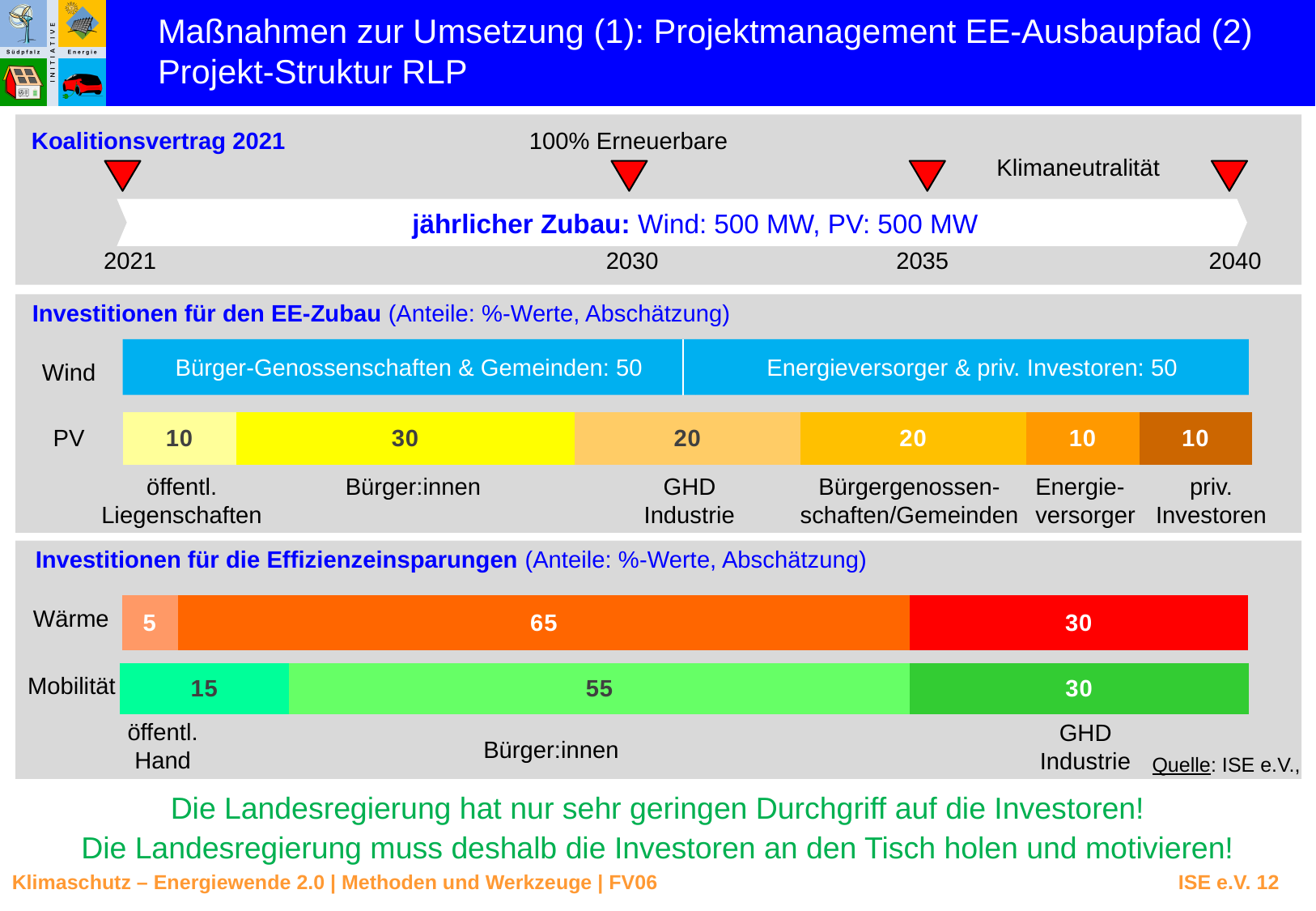
In the 'Investitionen für die Effizienzeinsparungen' chart, which is larger: the öffentl. Hand share for Wärme or for Mobilität? Mobilität What kind of chart is used in the 'Investitionen für den EE-Zubau' section? Stacked bar chart In the 'Investitionen für den EE-Zubau' chart, what share of PV investment is attributed to Bürger:innen? 30 In the 'Investitionen für die Effizienzeinsparungen' chart, what share of Wärme investment comes from Bürger:innen? 65 In the 'Investitionen für die Effizienzeinsparungen' chart, what is the difference between the Bürger:innen shares for Wärme and Mobilität? 10 In the 'Investitionen für die Effizienzeinsparungen' chart, what is the total of the Wärme bar? 100 In the 'Investitionen für den EE-Zubau' chart, what is the difference between the PV shares of Bürger:innen and GHD Industrie? 10 In the 'Investitionen für die Effizienzeinsparungen' chart, what share of Mobilität investment comes from öffentl. Hand? 15 In the 'Investitionen für den EE-Zubau' chart, which investor group has the largest share of PV investment? Bürger:innen In the 'Investitionen für die Effizienzeinsparungen' chart, which investor group has the smallest share of Wärme investment? öffentl. Hand In the 'Investitionen für den EE-Zubau' chart, how many investor segments make up the PV bar? 6 In the 'Investitionen für den EE-Zubau' chart, what share of Wind investment comes from Energieversorger & priv. Investoren? 50